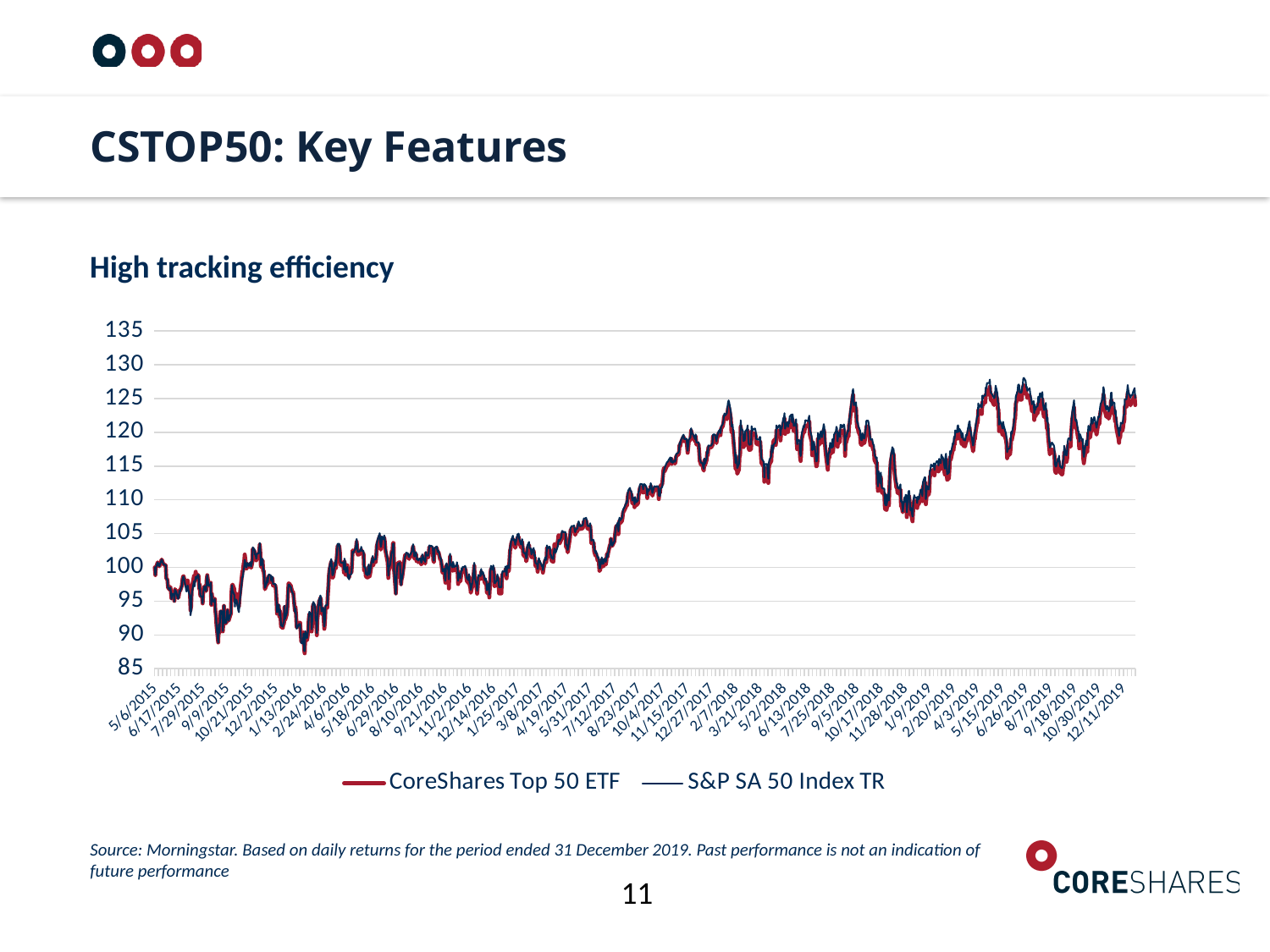
Is the highest point reached by the S&P SA 50 Index TR during 2019 greater or less than 120? greater What kind of chart is shown on the slide? line chart What is the heading shown above the chart? High tracking efficiency Is the lowest point reached by the CoreShares Top 50 ETF in early 2016 greater or less than 95? less Is the value of the CoreShares Top 50 ETF around 11/28/2018 greater or less than 115? less Overall, do the plotted values rise or fall from 5/6/2015 to 12/11/2019? rise Which series is drawn in red in the chart? CoreShares Top 50 ETF Do the values of the two series move together closely or diverge widely over the period? move together closely How many series does the legend list? 2